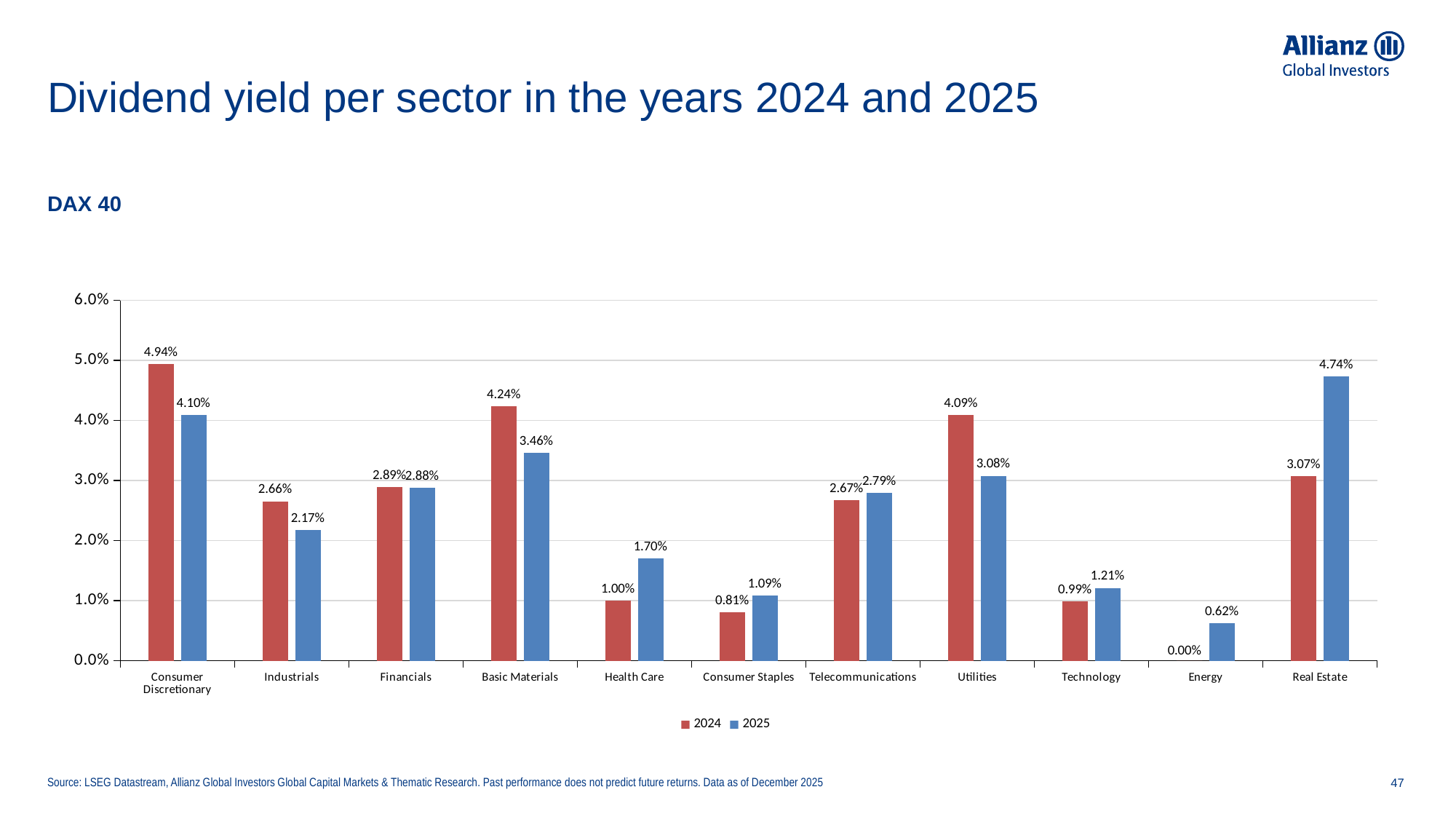
How many sectors are shown on the x axis? 11 Which sector has the highest 2024 dividend yield? Consumer Discretionary Is the 2024 dividend yield for Utilities higher or lower than its 2025 dividend yield? higher How many series does the legend list? 2 What is the 2024 dividend yield for Energy? 0.00% What is the difference between the 2025 and 2024 dividend yields for Real Estate? 1.67 percentage points Which sector has the highest 2025 dividend yield? Real Estate Which sector has the lowest 2025 dividend yield? Energy What is the 2025 dividend yield for Telecommunications? 2.79% What is the 2024 dividend yield for Consumer Discretionary? 4.94% What type of chart is shown on the slide? bar chart What is the 2025 dividend yield for Real Estate? 4.74%